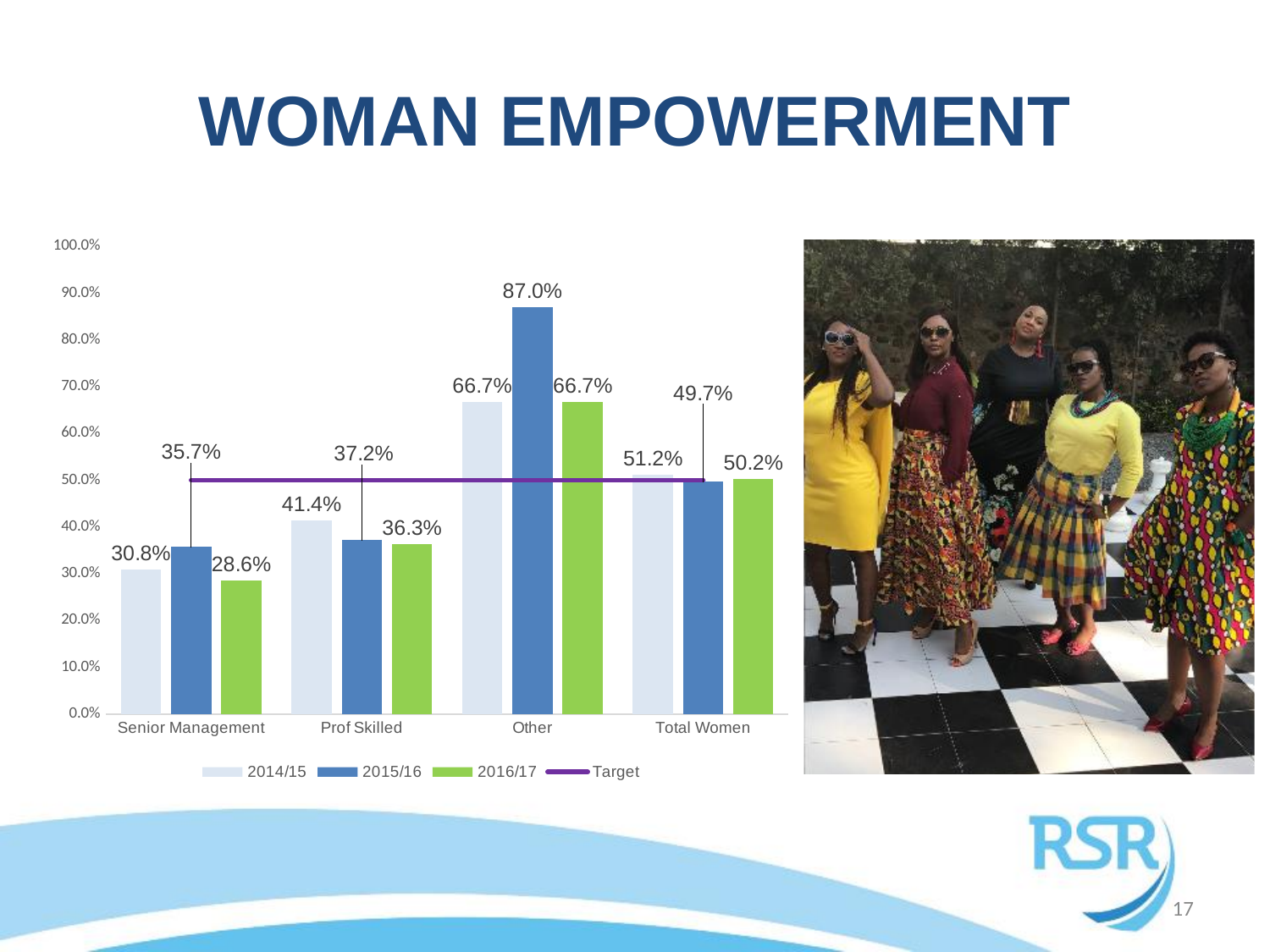
How many entries does the legend list? 4 Which is larger for Prof Skilled: the 2014/15 value or the 2016/17 value? 2014/15 What kind of chart is shown on the slide? combination bar and line chart (bars with a Target line) Which category has the lowest 2016/17 value? Senior Management Is the 2014/15 value for Senior Management greater or less than 40.0%? less What is the difference between the 2015/16 and 2014/15 values for Other? 20.3% What is the 2016/17 value for Senior Management? 28.6% Which category has the highest 2015/16 value? Other How many categories are shown on the x axis? 4 What is the 2014/15 value for Prof Skilled? 41.4% What is the 2015/16 value for Total Women? 49.7% What is the 2015/16 value for Other? 87.0%